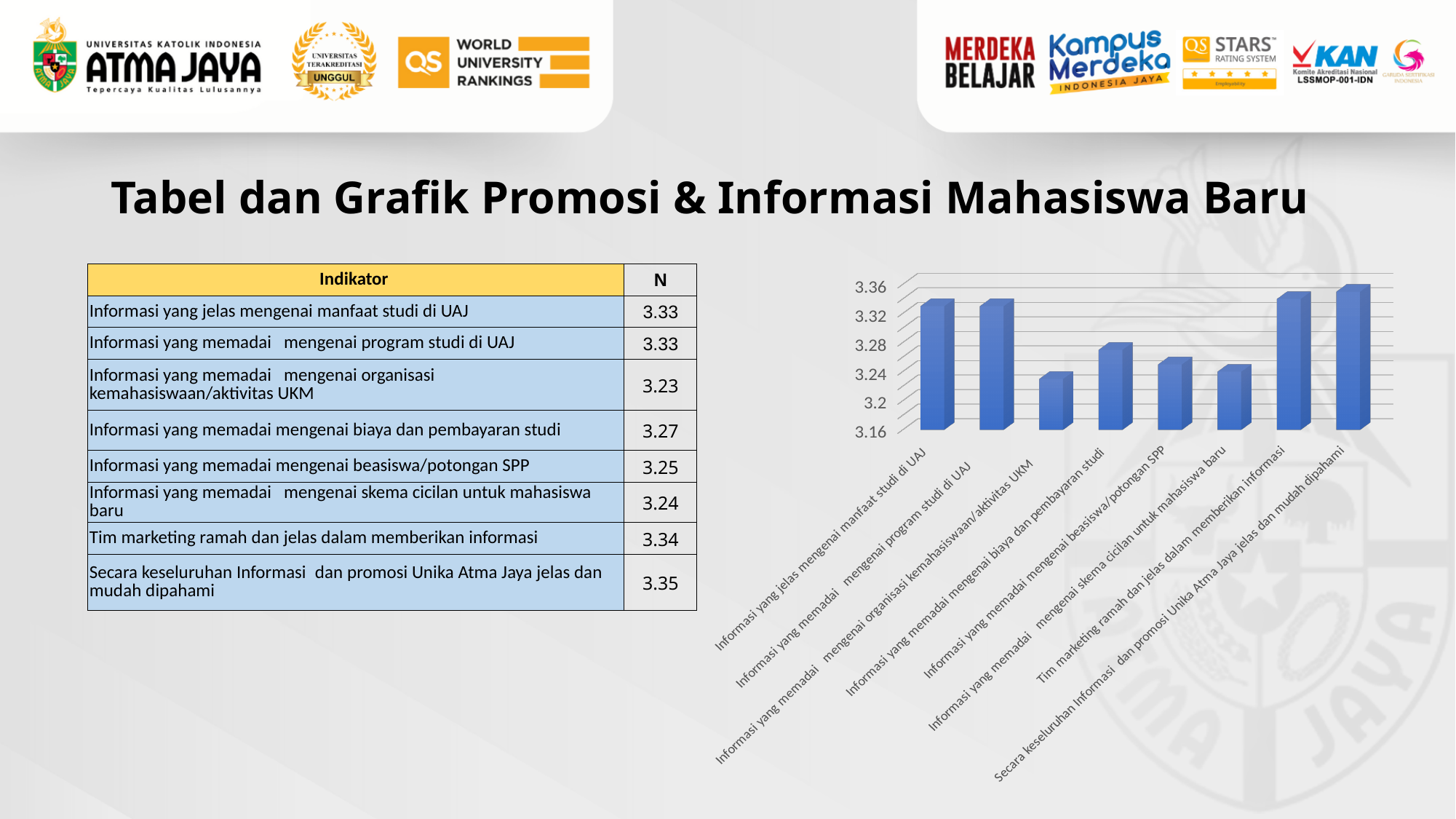
What is the value for 'Informasi yang memadai mengenai organisasi kemahasiswaan/aktivitas UKM'? 3.23 What is the difference between the values for 'Informasi yang memadai mengenai biaya dan pembayaran studi' and 'Informasi yang memadai mengenai beasiswa/potongan SPP'? 0.02 What is the value for 'Informasi yang memadai mengenai biaya dan pembayaran studi'? 3.27 Is the bar for 'Tim marketing ramah dan jelas dalam memberikan informasi' greater or less than 3.28? greater What is the value for 'Tim marketing ramah dan jelas dalam memberikan informasi'? 3.34 Which is larger: the value for 'Informasi yang jelas mengenai manfaat studi di UAJ' or for 'Informasi yang memadai mengenai organisasi kemahasiswaan/aktivitas UKM'? Informasi yang jelas mengenai manfaat studi di UAJ What is the highest tick value shown on the chart's vertical axis? 3.36 What kind of chart is shown on the slide? bar chart What is the difference between the values for 'Tim marketing ramah dan jelas dalam memberikan informasi' and 'Informasi yang memadai mengenai organisasi kemahasiswaan/aktivitas UKM'? 0.11 Is the bar for 'Informasi yang memadai mengenai biaya dan pembayaran studi' greater or less than 3.24? greater Which indicator has the highest value in the chart? Secara keseluruhan Informasi dan promosi Unika Atma Jaya jelas dan mudah dipahami How many bars (indicators) does the chart show? 8